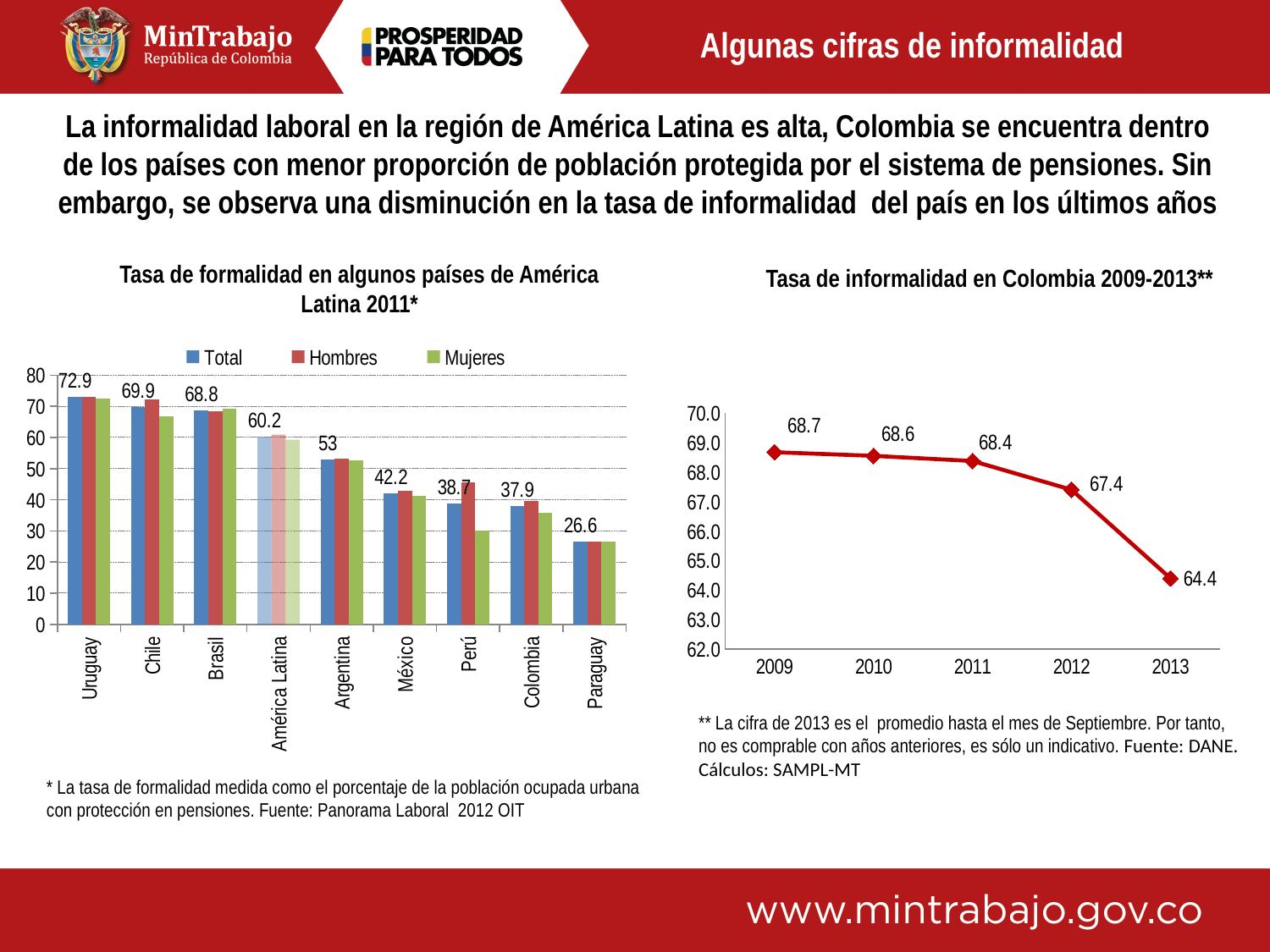
In the chart 'Tasa de formalidad en algunos países de América Latina 2011*', what is the Total value for Uruguay? 72.9 In the chart 'Tasa de formalidad en algunos países de América Latina 2011*', which country has the lowest Total value? Paraguay In the chart 'Tasa de formalidad en algunos países de América Latina 2011*', how many countries or regions are shown on the x axis? 9 In the chart 'Tasa de formalidad en algunos países de América Latina 2011*', which country has the highest Total value? Uruguay In the chart 'Tasa de formalidad en algunos países de América Latina 2011*', what is the difference between the Total values for Chile and Colombia? 32 In the chart 'Tasa de formalidad en algunos países de América Latina 2011*', how many series does the legend list? 3 In the chart 'Tasa de formalidad en algunos países de América Latina 2011*', what is the Total value for Colombia? 37.9 In the chart 'Tasa de informalidad en Colombia 2009-2013**', what is the value for 2012? 67.4 What kind of chart is 'Tasa de informalidad en Colombia 2009-2013**'? line chart In the chart 'Tasa de formalidad en algunos países de América Latina 2011*', is the Mujeres value for Perú greater or less than 40? less In the chart 'Tasa de informalidad en Colombia 2009-2013**', what is the difference between the values for 2009 and 2013? 4.3 In the chart 'Tasa de informalidad en Colombia 2009-2013**', do the values rise or fall from 2009 to 2013? fall